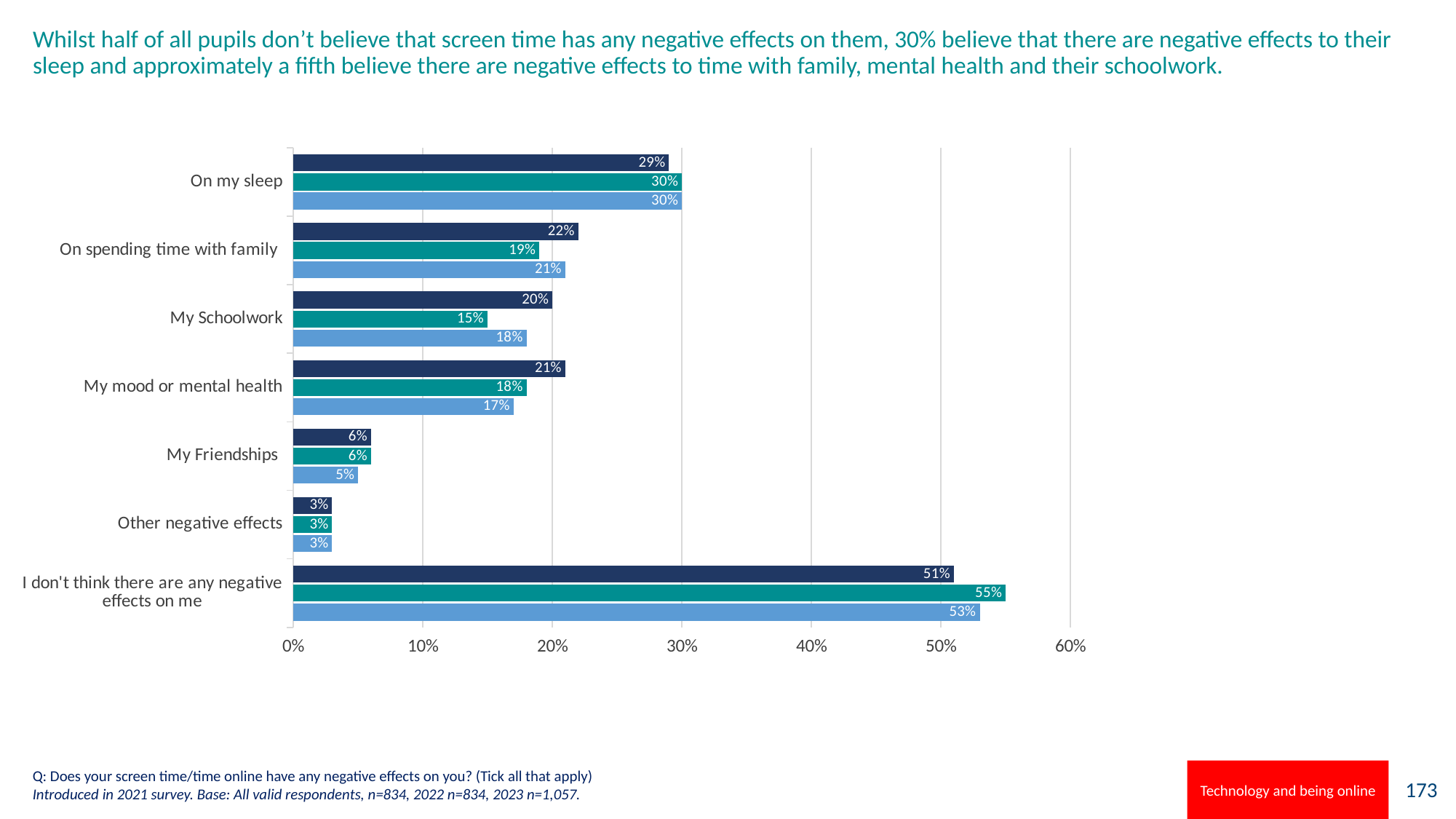
What kind of chart is shown on the slide? bar chart How many categories are listed on the vertical axis of the chart? 7 What is the value of the teal (middle) bar for 'On my sleep'? 30% Which category has the highest dark navy (top) bar value? I don't think there are any negative effects on me How many bars are shown for each category in the chart? 3 Which category has the lowest light blue (bottom) bar value? Other negative effects What is the value of the dark navy (top) bar for 'On spending time with family'? 22% Which is larger for 'My mood or mental health': the dark navy (top) bar or the light blue (bottom) bar? the dark navy (top) bar Is the teal (middle) bar for 'I don't think there are any negative effects on me' greater or less than 50%? greater What is the value of the light blue (bottom) bar for 'My Schoolwork'? 18% What is the difference between the dark navy (top) bar and the teal (middle) bar for 'My Schoolwork'? 5% What is the value of the teal (middle) bar for 'I don't think there are any negative effects on me'? 55%